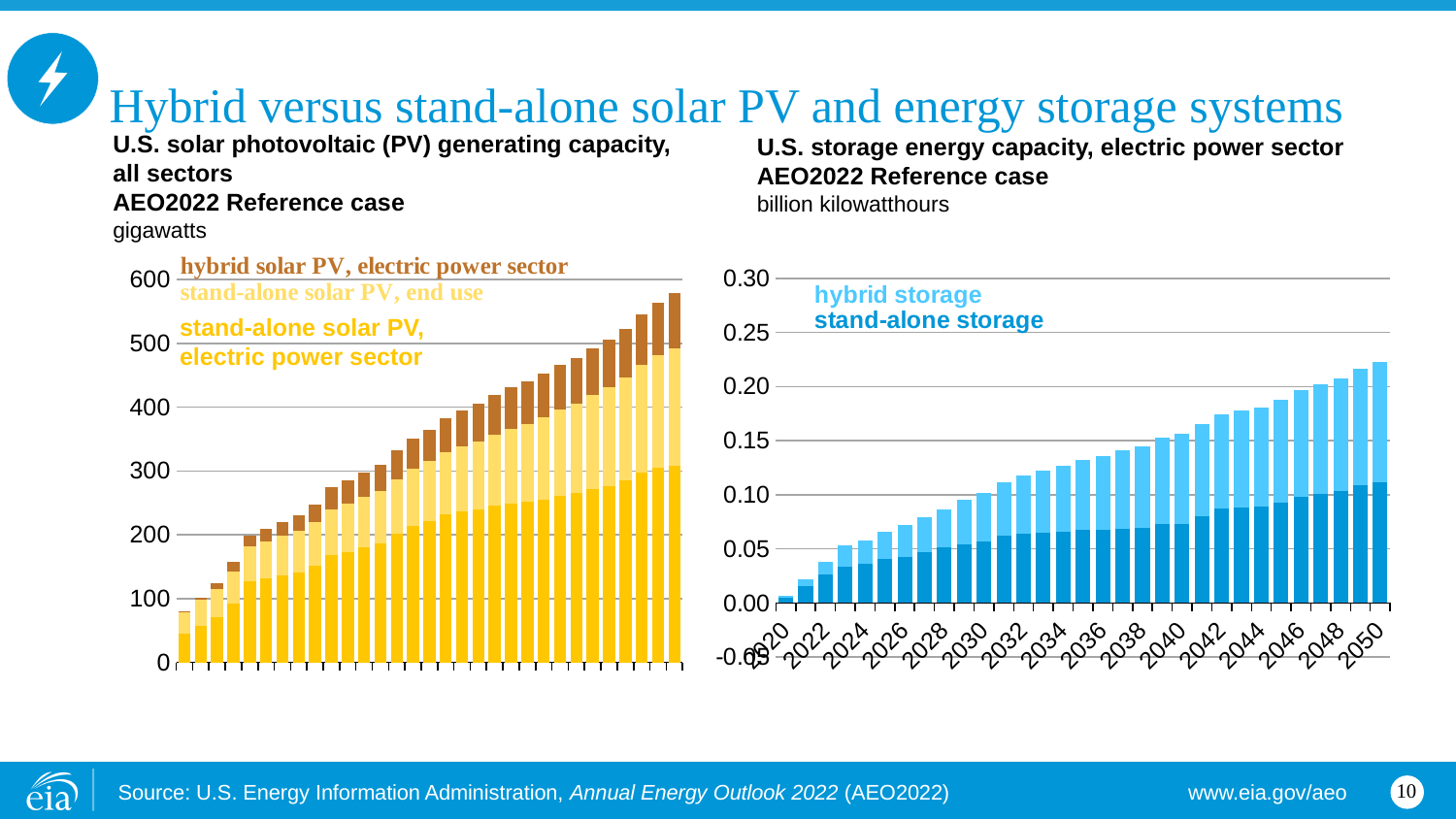
In the U.S. storage energy capacity chart, is the total value for 2050 greater or less than 0.20? greater In the U.S. storage energy capacity chart, is the total value for 2020 greater or less than 0.05? less In the U.S. storage energy capacity chart, is the total value for 2046 greater or less than 0.15? greater What unit is used on the y axis of the U.S. solar photovoltaic (PV) generating capacity chart? gigawatts What unit is used on the y axis of the U.S. storage energy capacity chart? billion kilowatthours In the U.S. storage energy capacity chart, which year has the highest total storage energy capacity? 2050 How many series does the legend of the U.S. storage energy capacity chart list? 2 In the U.S. storage energy capacity chart, do total values rise or fall from 2020 to 2050? rise What kind of chart is the U.S. storage energy capacity chart on the right? stacked bar chart How many series does the legend of the U.S. solar photovoltaic (PV) generating capacity chart list? 3 What kind of chart is the U.S. solar photovoltaic (PV) generating capacity chart on the left? stacked bar chart